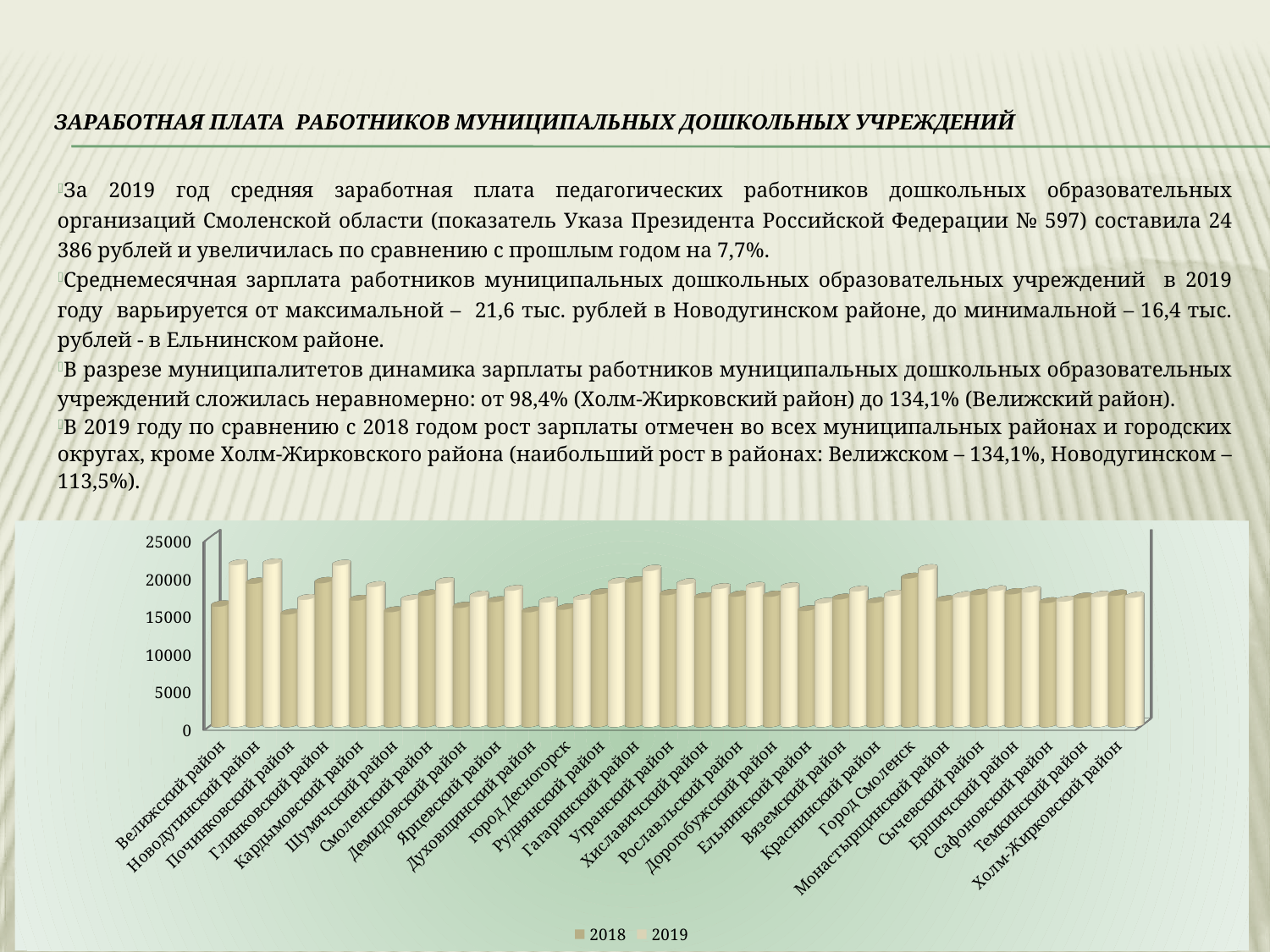
Is the 2019 value for Ельнинский район greater or less than 20000? less What is the highest value shown on the vertical axis of the chart? 25000 What kind of chart is shown on the slide? bar chart Is the 2019 value for Новодугинский район greater or less than 20000? greater How many districts (categories) are shown on the x axis of the chart? 27 For Велижский район, which is larger: the 2018 value or the 2019 value? 2019 Is the 2018 value for Велижский район greater or less than 20000? less Which years are listed in the chart legend? 2018 and 2019 How many series does the chart legend list? 2